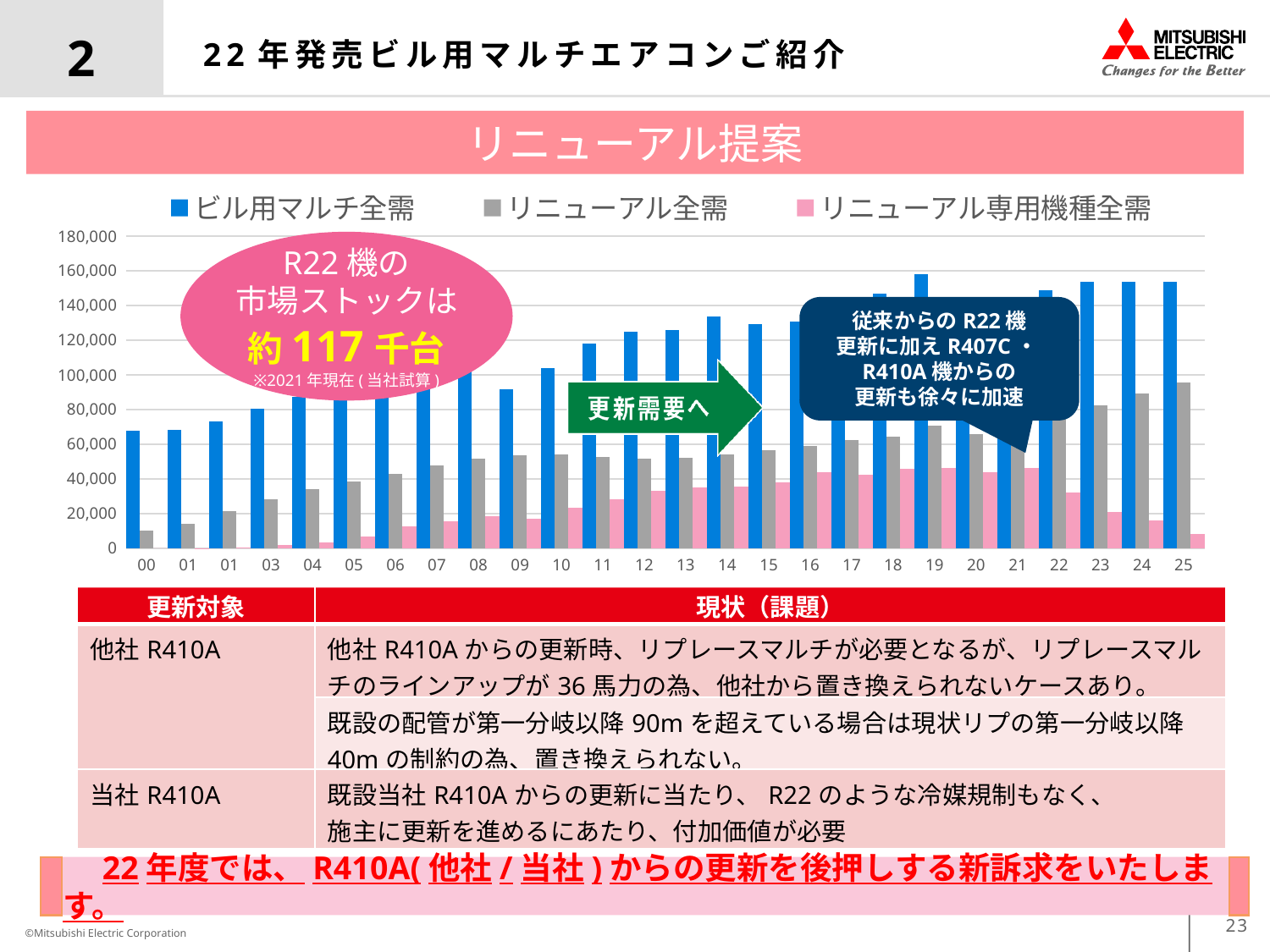
What kind of chart is shown on the slide? bar chart Is the value of リニューアル全需 for 25 greater or less than 80,000? greater Which year has the highest value for リニューアル全需? 25 Is the value of ビル用マルチ全需 for 00 greater or less than 60,000? greater How many year categories are shown along the x axis of the chart? 26 Which is larger, the ビル用マルチ全需 value for 00 or for 25? 25 Does the リニューアル全需 series generally rise or fall from 00 to 25? rise Is the value of リニューアル専用機種全需 for 25 greater or less than 20,000? less How many series does the chart legend list? 3 Which year has the lowest value for リニューアル全需? 00 What colour represents リニューアル専用機種全需 in the chart? pink